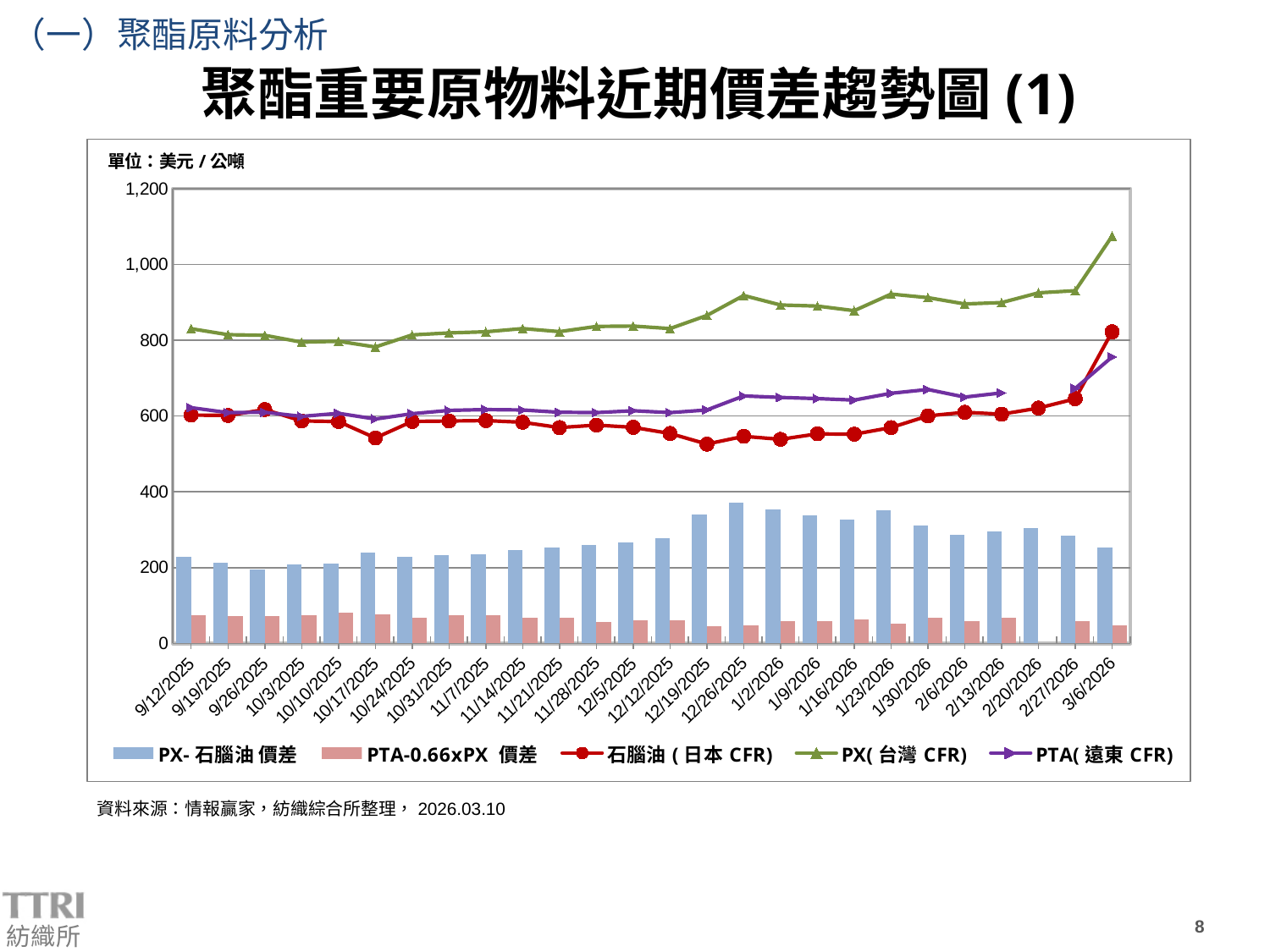
On which date is the PX- 石腦油 價差 bar the tallest? 12/26/2025 Is the PTA-0.66xPX 價差 bar on 10/10/2025 greater or less than 200? less On which date does PX( 台灣 CFR) reach its highest value? 3/6/2026 How many series does the legend list? 5 Which is higher on 9/12/2025, PX( 台灣 CFR) or 石腦油 ( 日本 CFR)? PX( 台灣 CFR) Is the value of 石腦油 ( 日本 CFR) on 12/19/2025 greater or less than 600? less Is the PX- 石腦油 價差 bar on 12/26/2025 greater or less than 400? less What kind of chart is this? Combination bar and line chart What unit is stated for the chart values? 美元 / 公噸 Does the PX( 台灣 CFR) line overall rise or fall from 9/12/2025 to 3/6/2026? rise How many dates are shown along the x axis? 26